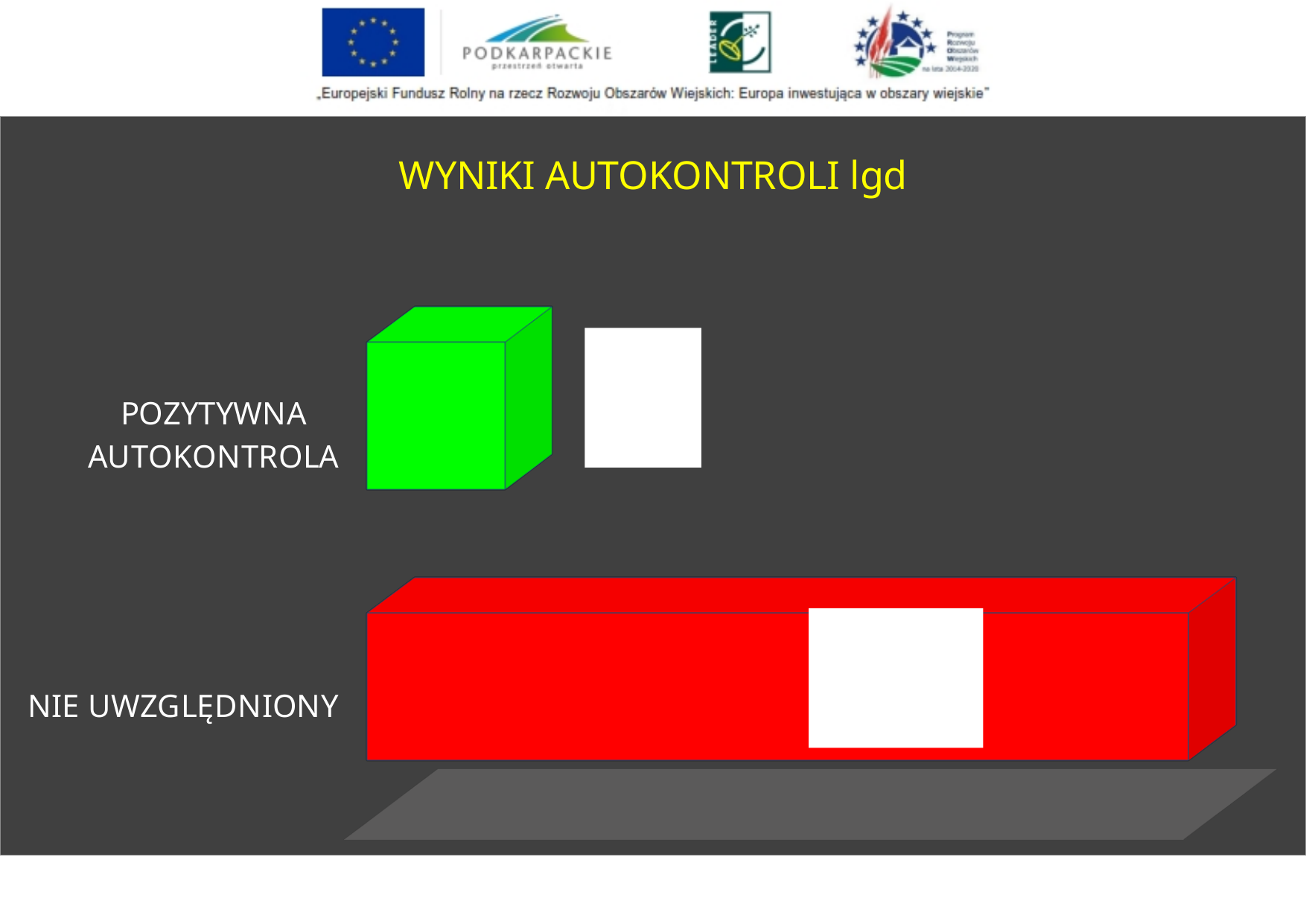
Which category has the longest bar? NIE UWZGLĘDNIONY How many categories does the chart show? 2 Which bar is longer: POZYTYWNA AUTOKONTROLA or NIE UWZGLĘDNIONY? NIE UWZGLĘDNIONY What colour is the bar for NIE UWZGLĘDNIONY? red What kind of chart is shown on the slide? bar chart Which category has the shortest bar? POZYTYWNA AUTOKONTROLA What is the title of the chart? WYNIKI AUTOKONTROLI lgd